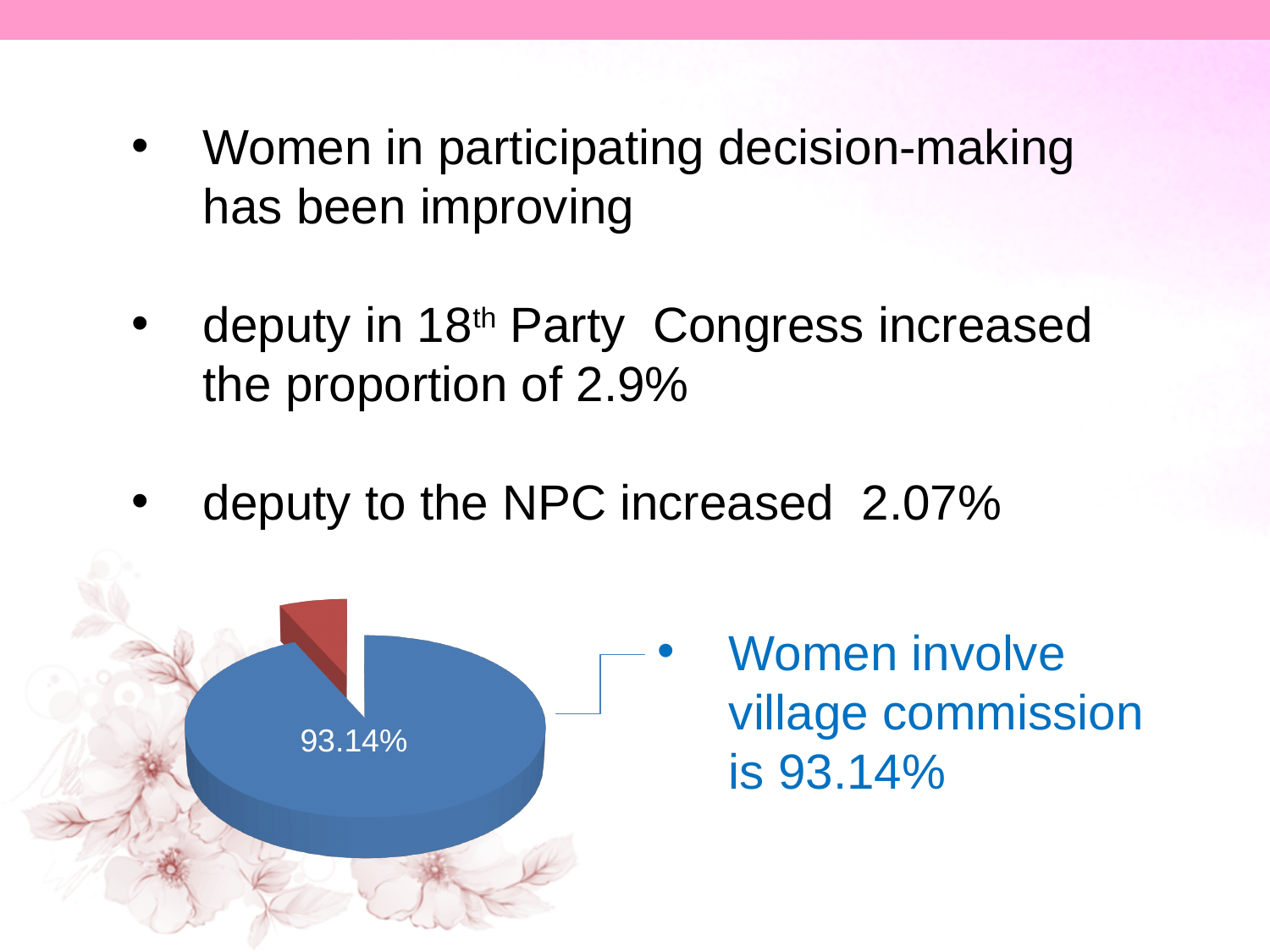
Which is larger in the pie chart, the blue slice or the red slice? the blue slice What colour is the slice that is pulled out from the pie chart? red What kind of chart is shown on the slide? pie chart How many slices of the pie chart have a printed data label? 1 What share of the pie does the blue slice represent? 93.14% Which slice of the pie chart is the smallest? the red slice Which slice of the pie chart is the largest? the blue slice Is the share of the blue slice greater or less than 50%? greater What value is printed on the large blue slice of the pie chart? 93.14% How many slices does the pie chart have? 2